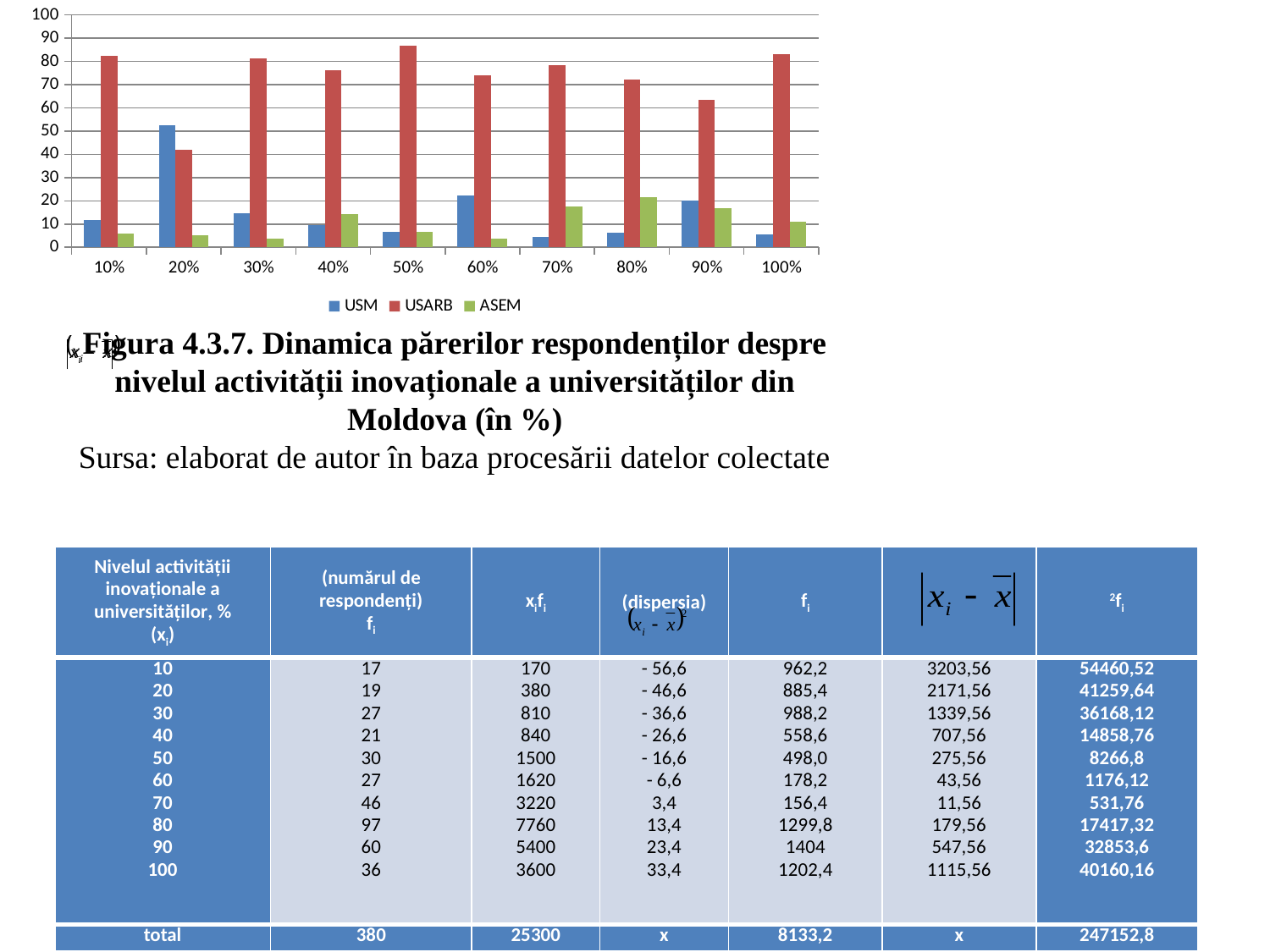
For which category is the USARB series lowest? 20% Is the USARB value for 20% greater or less than 50? less Is the USM value for 20% greater or less than 40? greater At 20%, which series has the larger value, USM or USARB? USM Which series is shown in red in the chart? USARB What kind of chart is shown on the slide? bar chart How many categories are shown along the x axis of the chart? 10 For which category is the USM series highest? 20% How many series does the chart legend list? 3 Is the USARB value for 50% greater or less than 80? greater At 80%, which series has the larger value, USM or ASEM? ASEM For which category is the ASEM series highest? 80%